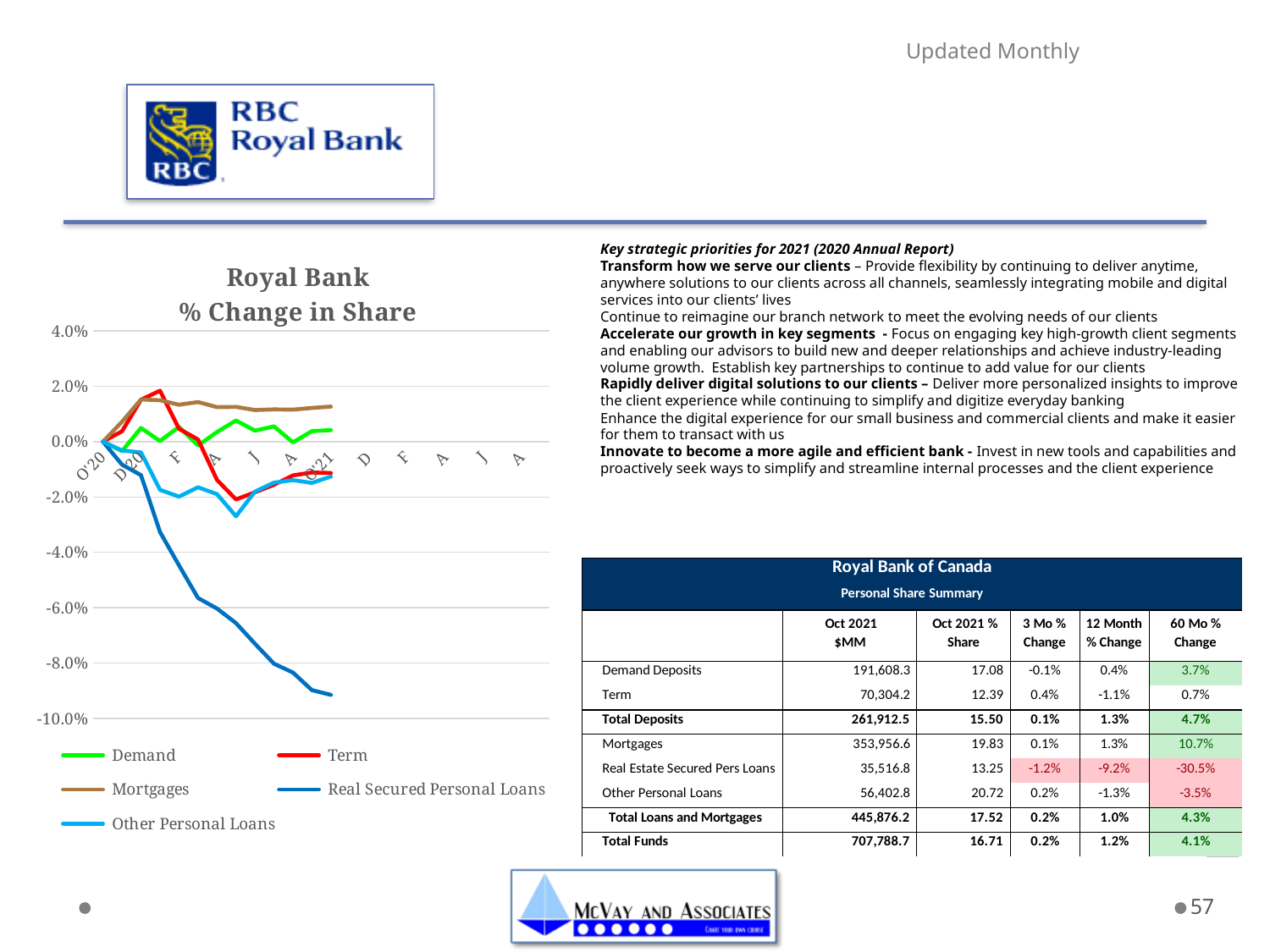
At O'21, which is larger: the value for Mortgages or the value for Real Secured Personal Loans? Mortgages Which series has the highest value at O'21? Mortgages Is the value for Real Secured Personal Loans at A (April 2021) greater or less than -4.0%? less Is the value for Mortgages at O'21 greater or less than 0.0%? greater Is the value for Real Secured Personal Loans at O'21 greater or less than -8.0%? less Which series has the lowest value at O'21? Real Secured Personal Loans What kind of chart is shown on the slide? line chart Which colour is used for the Demand series in the chart? green Does the Real Secured Personal Loans series rise or fall from O'20 to O'21? fall What is the title of the chart? Royal Bank % Change in Share How many series does the legend of the chart list? 5